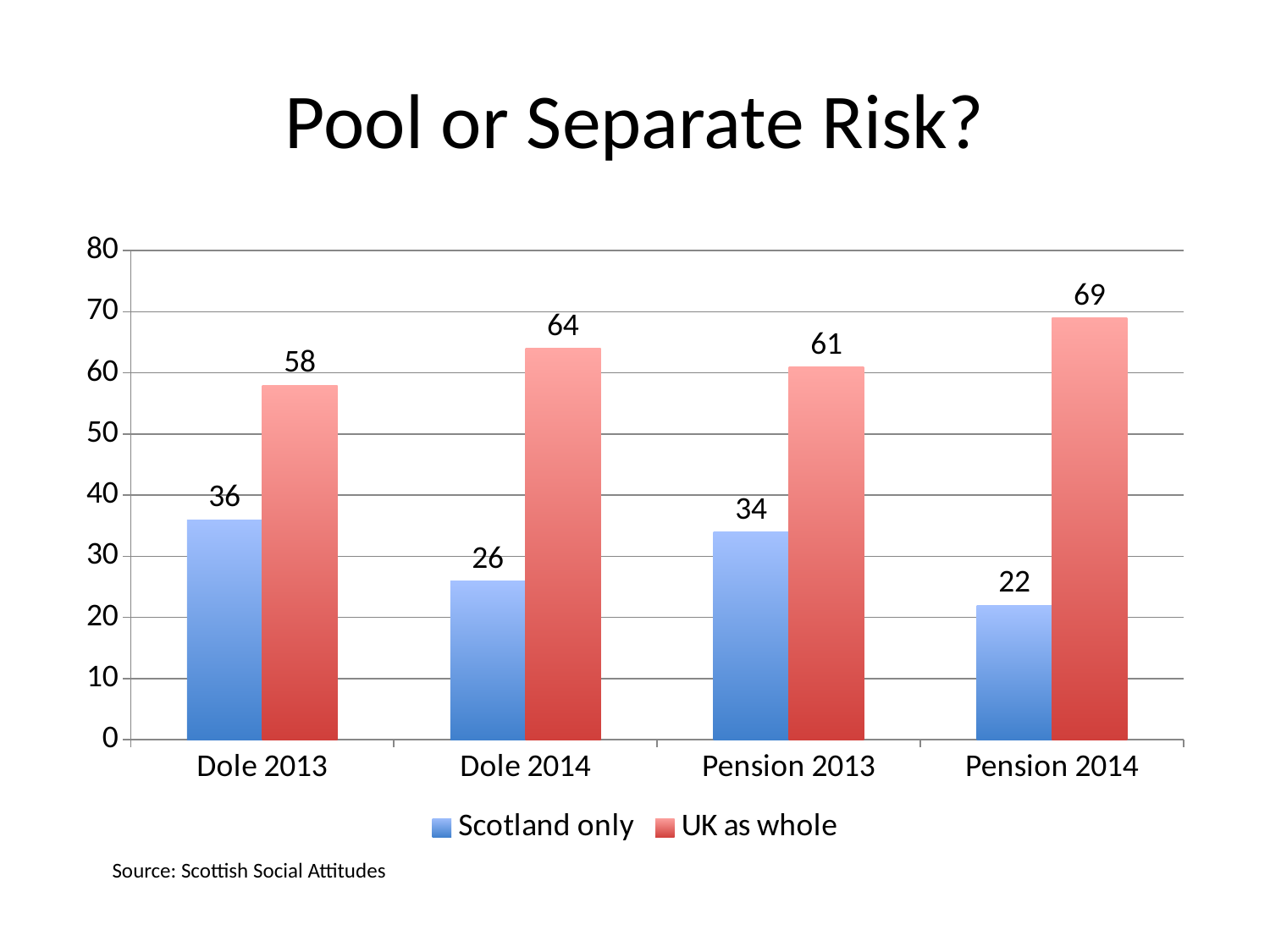
How many series does the legend list? 2 Which category has the lowest value for Scotland only? Pension 2014 Is the value for Scotland only in Pension 2013 greater or less than 40? less Which category has the highest value for UK as whole? Pension 2014 What kind of chart is shown on the slide? bar chart What is the title of the chart? Pool or Separate Risk? What is the difference between UK as whole and Scotland only in Pension 2013? 27 What is the value for UK as whole in Dole 2014? 64 How many categories are shown on the x axis? 4 What is the value for Scotland only in Dole 2013? 36 What is the value for UK as whole in Pension 2014? 69 Which is larger in Dole 2014: Scotland only or UK as whole? UK as whole